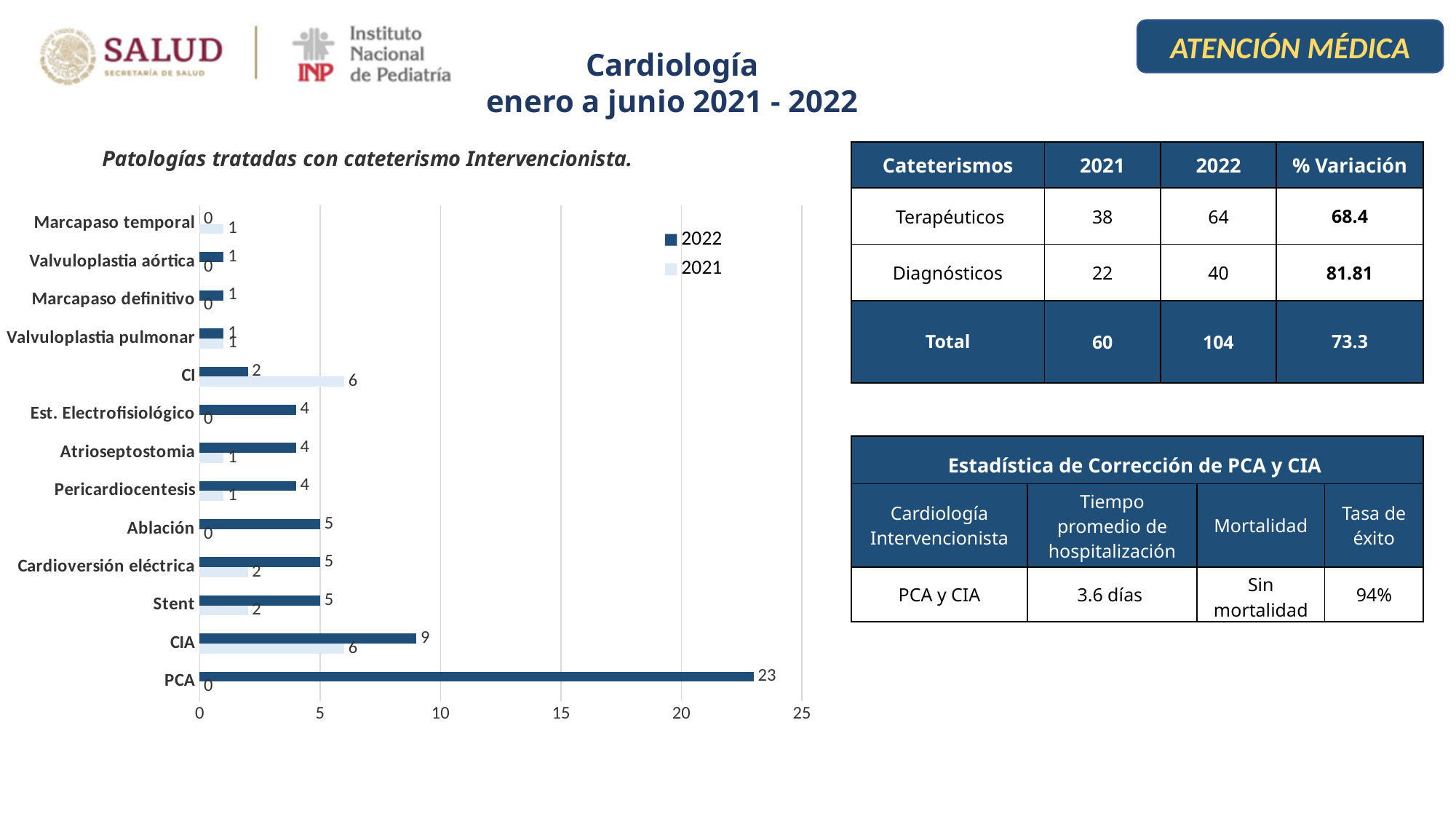
What is the difference between the 2022 and 2021 values for CIA? 3 How many categories (pathologies) are shown on the chart? 13 What is the 2022 value for Stent? 5 What is the 2022 value for PCA? 23 What type of chart is shown on the slide? bar chart Is the 2022 value for PCA greater or less than 20? greater What is the title of the chart? Patologías tratadas con cateterismo Intervencionista. What is the 2021 value for CI? 6 Which category has the highest 2022 value? PCA What is the 2021 value for CIA? 6 How many series does the chart legend list? 2 Which is larger for CI: the 2022 value or the 2021 value? 2021